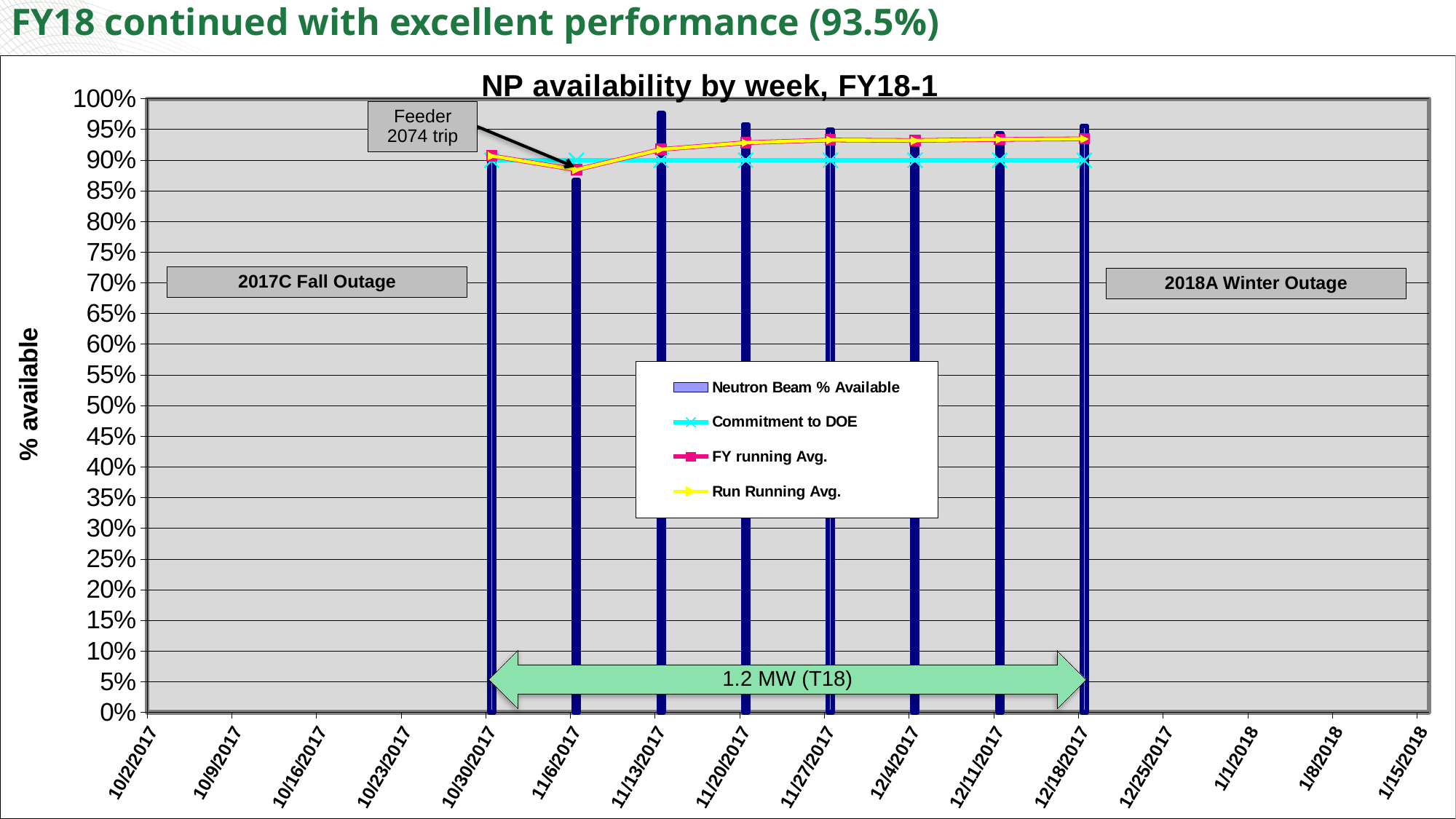
Which week has the lowest Neutron Beam % Available bar? 11/6/2017 What kind of chart is shown on the slide? Bar chart with line series Which week has the larger Neutron Beam % Available bar, 11/6/2017 or 11/13/2017? 11/13/2017 Is the Neutron Beam % Available value for 11/6/2017 greater or less than 90%? less Which week has the highest Neutron Beam % Available bar? 11/13/2017 Which week is annotated with the 'Feeder 2074 trip' label? 11/6/2017 What is the title of the chart? NP availability by week, FY18-1 How many weeks have a Neutron Beam % Available bar plotted? 8 Is the Neutron Beam % Available value for 11/13/2017 greater or less than 95%? greater How many series does the legend list? 4 Does the FY running Avg. line rise or fall from 11/6/2017 to 12/18/2017? rise At what level does the Commitment to DOE line sit? 90%